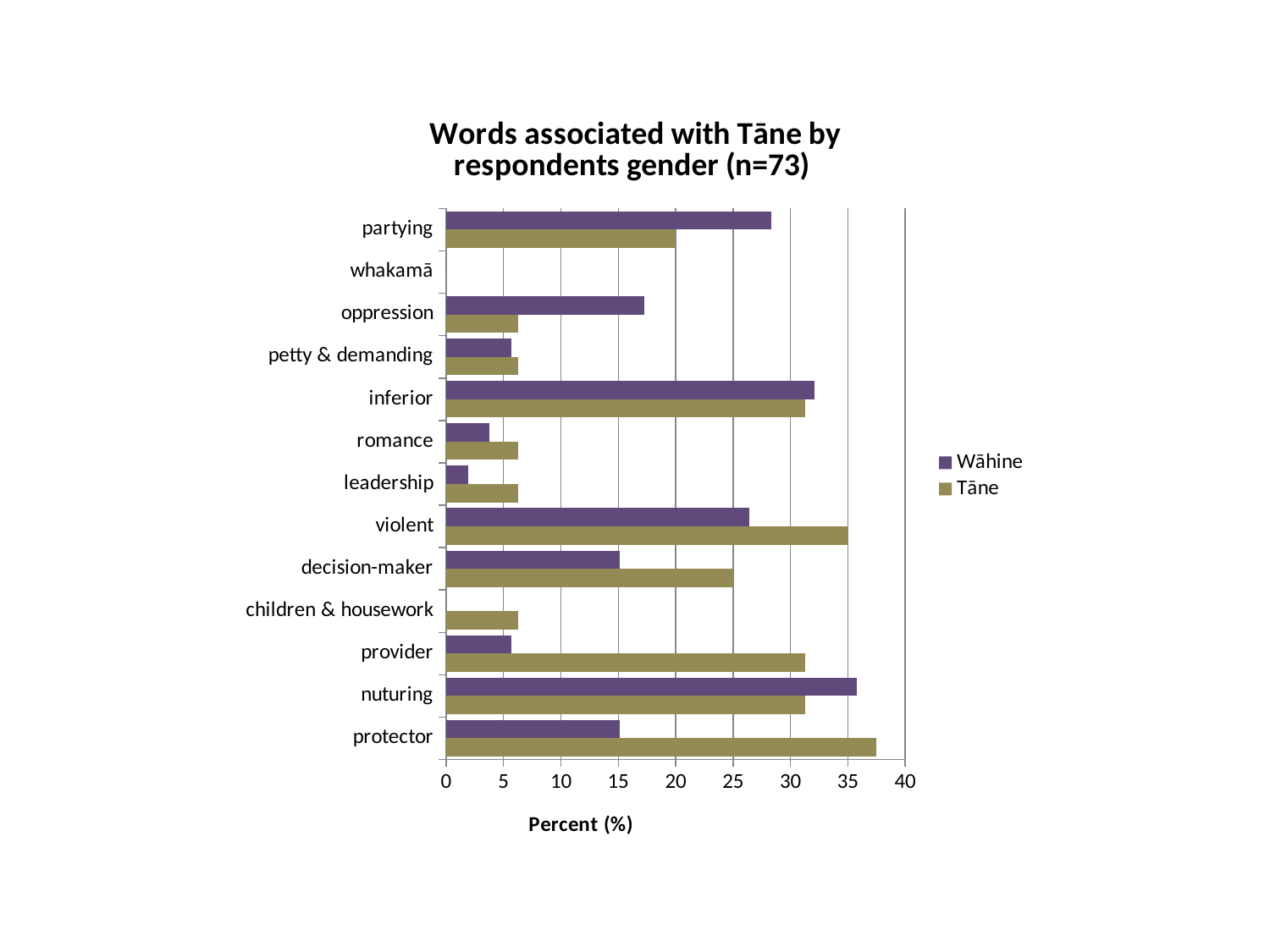
Is the Wāhine value for leadership greater or less than 5? less Is the Tāne value for protector greater or less than 35? greater How many word categories are listed on the vertical axis? 13 Which category has the highest Tāne value? protector How many series does the legend list? 2 Which series is shown in purple? Wāhine For provider, which series has the larger value, Wāhine or Tāne? Tāne Which category has the highest Wāhine value? nuturing For violent, which series has the larger value, Wāhine or Tāne? Tāne Is the Wāhine value for partying greater or less than 25? greater What kind of chart is shown on the slide? Bar chart What is the label of the horizontal axis? Percent (%)